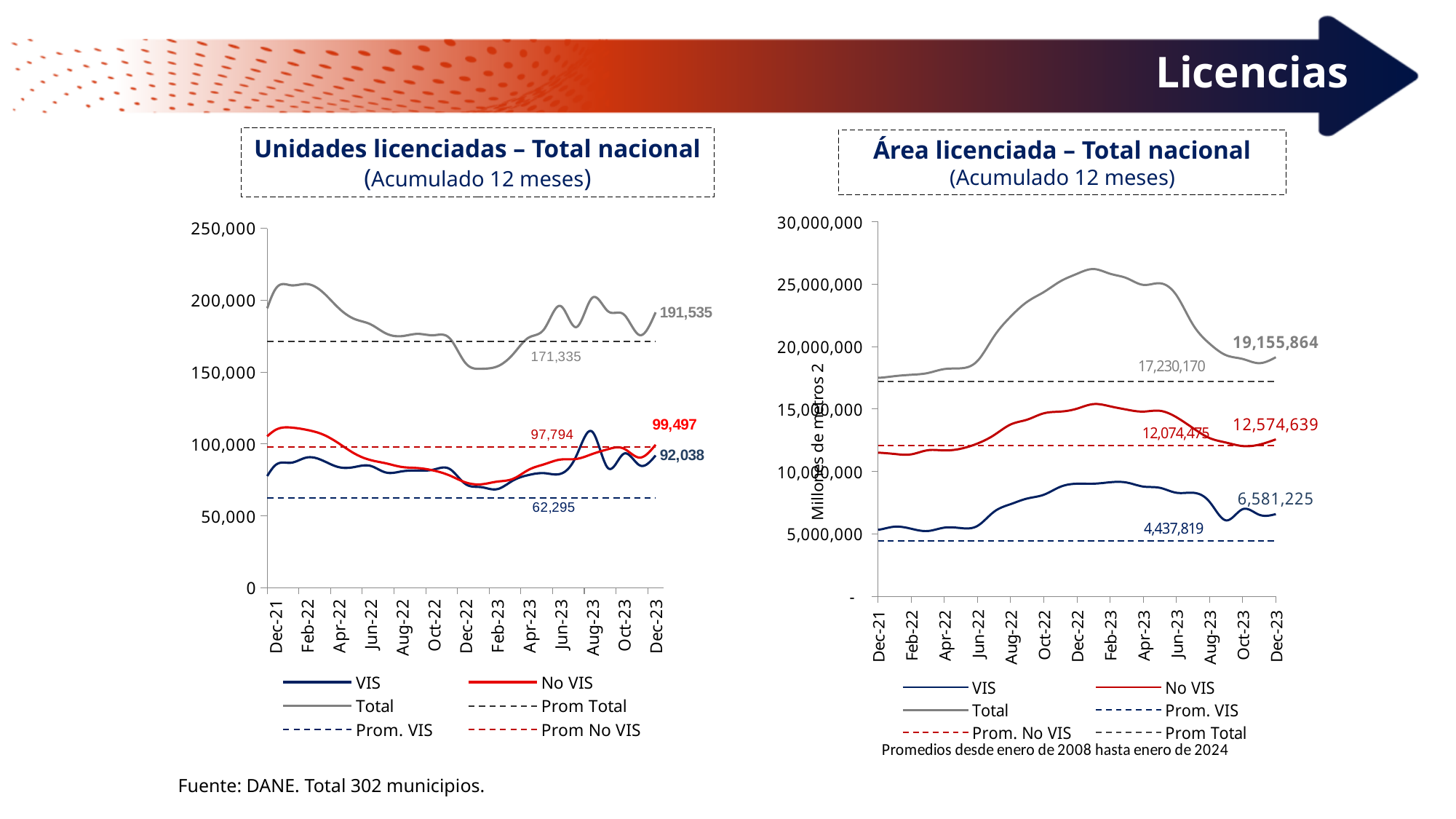
In the 'Área licenciada – Total nacional' chart, is the Total series value at Dec-22 greater or less than 25,000,000? greater In the 'Unidades licenciadas – Total nacional' chart, what is the labelled value of the Total series at Dec-23? 191,535 In the 'Unidades licenciadas – Total nacional' chart, what value is labelled on the Prom. VIS dashed line? 62,295 How many series does the legend of the 'Área licenciada – Total nacional' chart list? 6 In the 'Área licenciada – Total nacional' chart, what is the difference between the Dec-23 No VIS value (12,574,639) and the Prom. No VIS value (12,074,475)? 500,164 In the 'Área licenciada – Total nacional' chart, what value is labelled on the Prom. No VIS dashed line? 12,074,475 In the 'Unidades licenciadas – Total nacional' chart, what is the labelled value of the No VIS series at Dec-23? 99,497 What kind of chart is the 'Unidades licenciadas – Total nacional' chart? Line chart In the 'Área licenciada – Total nacional' chart, what is the labelled value of the VIS series at Dec-23? 6,581,225 In the 'Unidades licenciadas – Total nacional' chart, is the Dec-23 Total value (191,535) greater or less than the Prom Total value (171,335)? greater In the 'Unidades licenciadas – Total nacional' chart, what is the difference between the Dec-23 No VIS value (99,497) and the Dec-23 VIS value (92,038)? 7,459 In the 'Área licenciada – Total nacional' chart, what is the labelled value of the Total series at Dec-23? 19,155,864